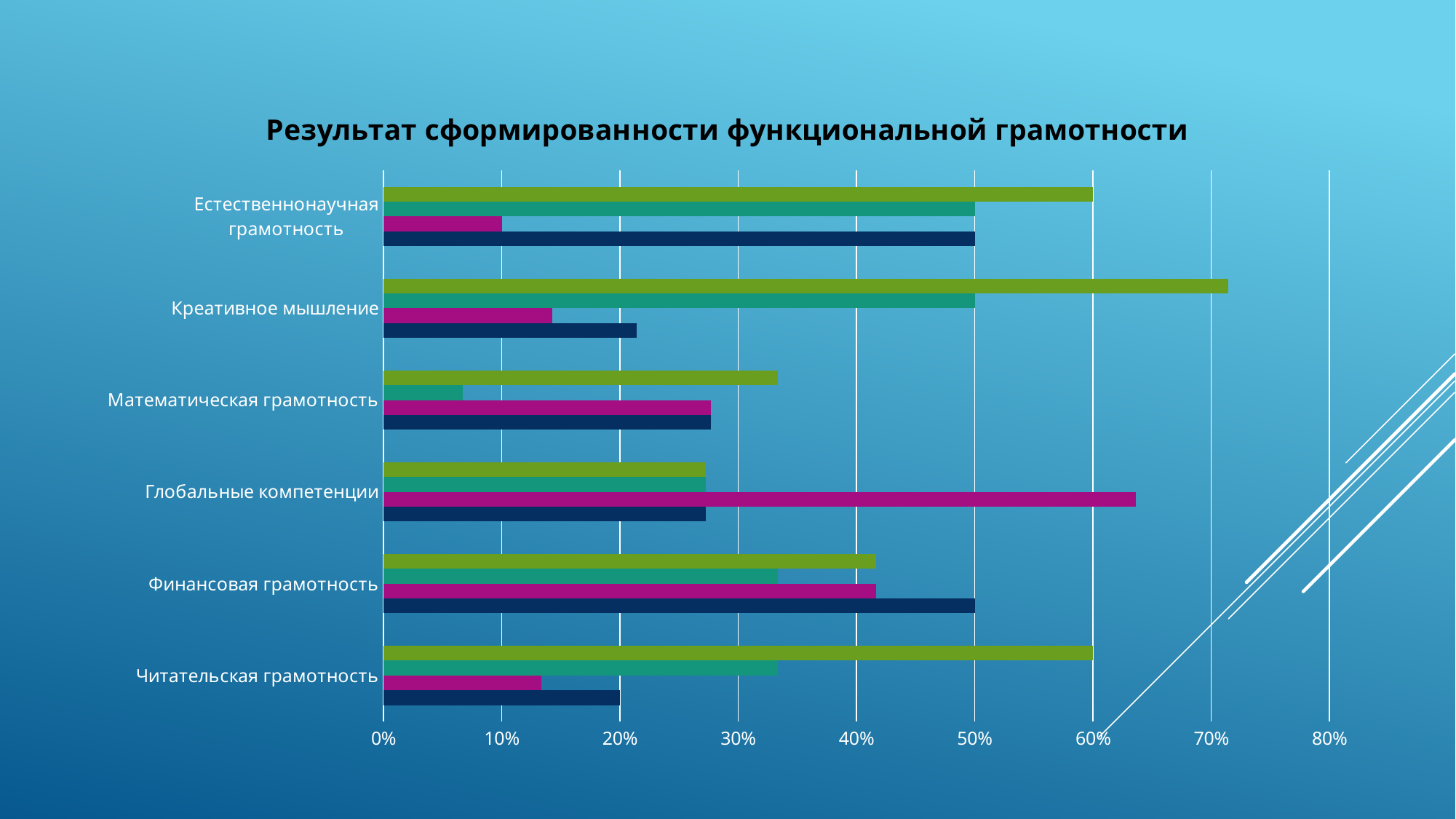
Is the value of the magenta bar for Глобальные компетенции greater or less than 60%? greater What is the value of the dark navy bar for Финансовая грамотность? 50% What is the value of the green bar for Естественнонаучная грамотность? 60% What is the title of the chart? Результат сформированности функциональной грамотности Is the value of the green bar for Креативное мышление greater or less than 60%? greater What is the value of the magenta bar for Естественнонаучная грамотность? 10% Which category has the longest green bar? Креативное мышление How many categories are shown on the vertical axis of the chart? 6 What kind of chart is shown on the slide? bar chart What is the value of the dark navy bar for Читательская грамотность? 20% How many bars are plotted for each category in the chart? 4 For Математическая грамотность, which is larger: the green bar or the teal bar? the green bar